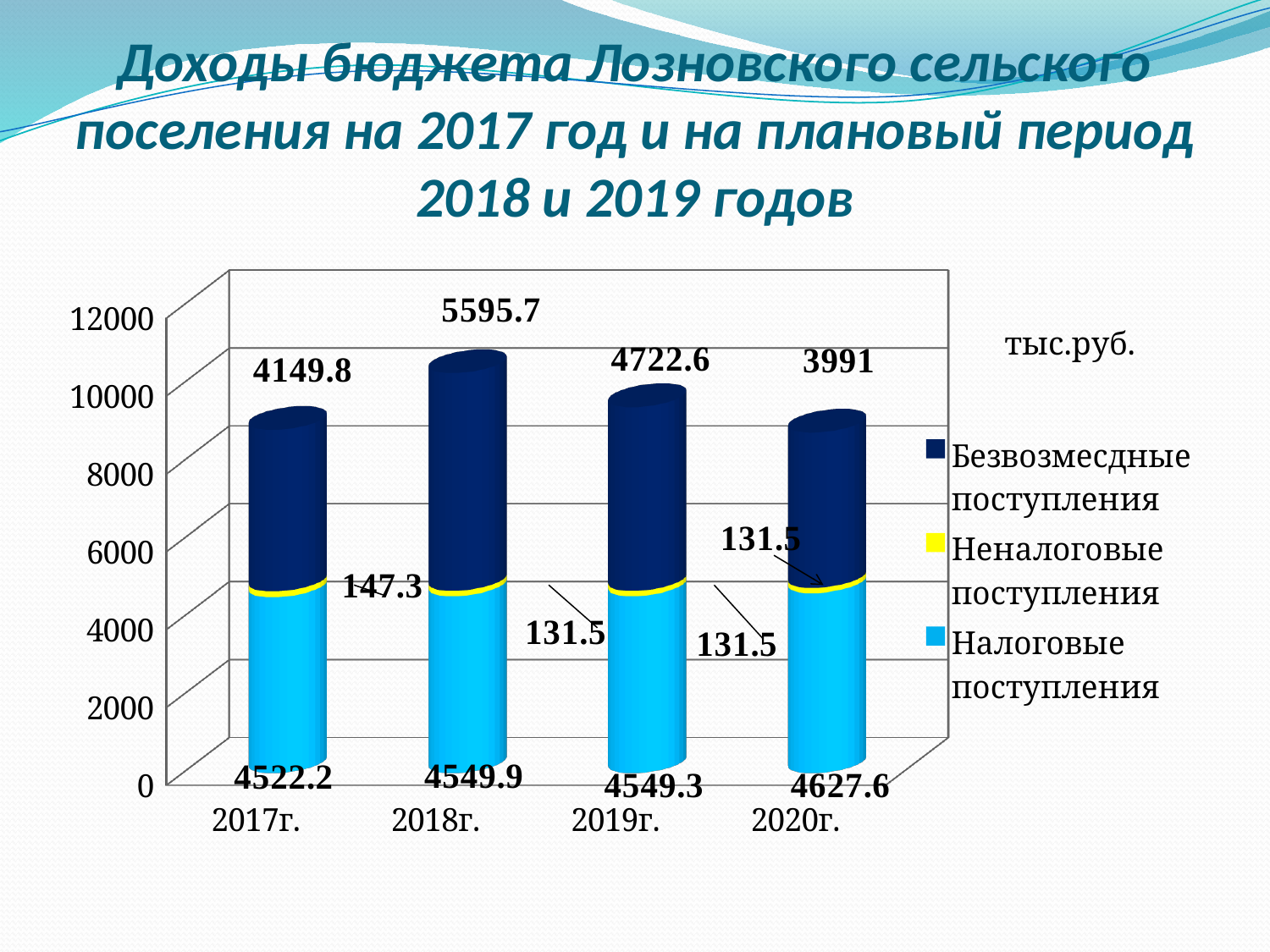
How many years are shown on the x axis? 4 What is the difference between Безвозмесдные поступления in 2018г. and 2019г.? 873.1 What is the value of Неналоговые поступления for 2017г.? 147.3 Which is larger: Налоговые поступления in 2017г. or in 2020г.? 2020г. Which year has the highest value for Безвозмесдные поступления? 2018г. What is the value of Налоговые поступления for 2020г.? 4627.6 What is the total of the stacked bar for 2018г.? 10277.1 What kind of chart is shown on the slide? stacked bar chart What is the value of Безвозмесдные поступления for 2018г.? 5595.7 How many series does the legend list? 3 Which year has the lowest value for Безвозмесдные поступления? 2020г. Is the total height of the 2017г. bar greater or less than 10000? less